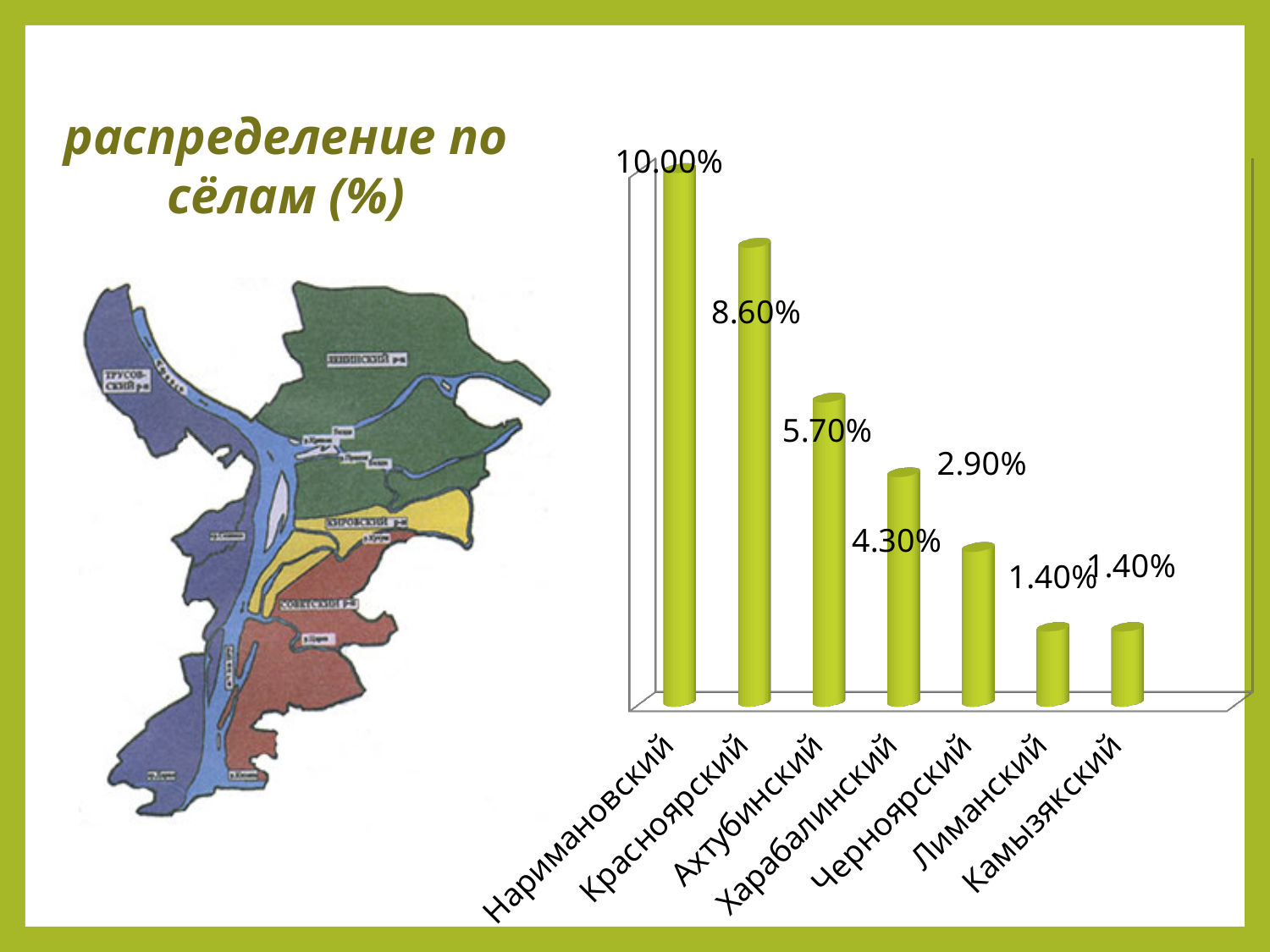
How many categories are shown on the chart? 7 What is the value for Черноярский? 2.90% What is the value for Ахтубинский? 5.70% What kind of chart is shown on the slide? bar chart What is the value for Наримановский? 10.00% Which category has the highest value? Наримановский Do the values rise or fall from left to right along the x axis? fall Which is larger, the value for Красноярский or the value for Ахтубинский? Красноярский What is the title of the chart? распределение по сёлам (%) What is the difference between the values for Наримановский and Красноярский? 1.40% What is the value for Красноярский? 8.60% What is the difference between the values for Ахтубинский and Харабалинский? 1.40%